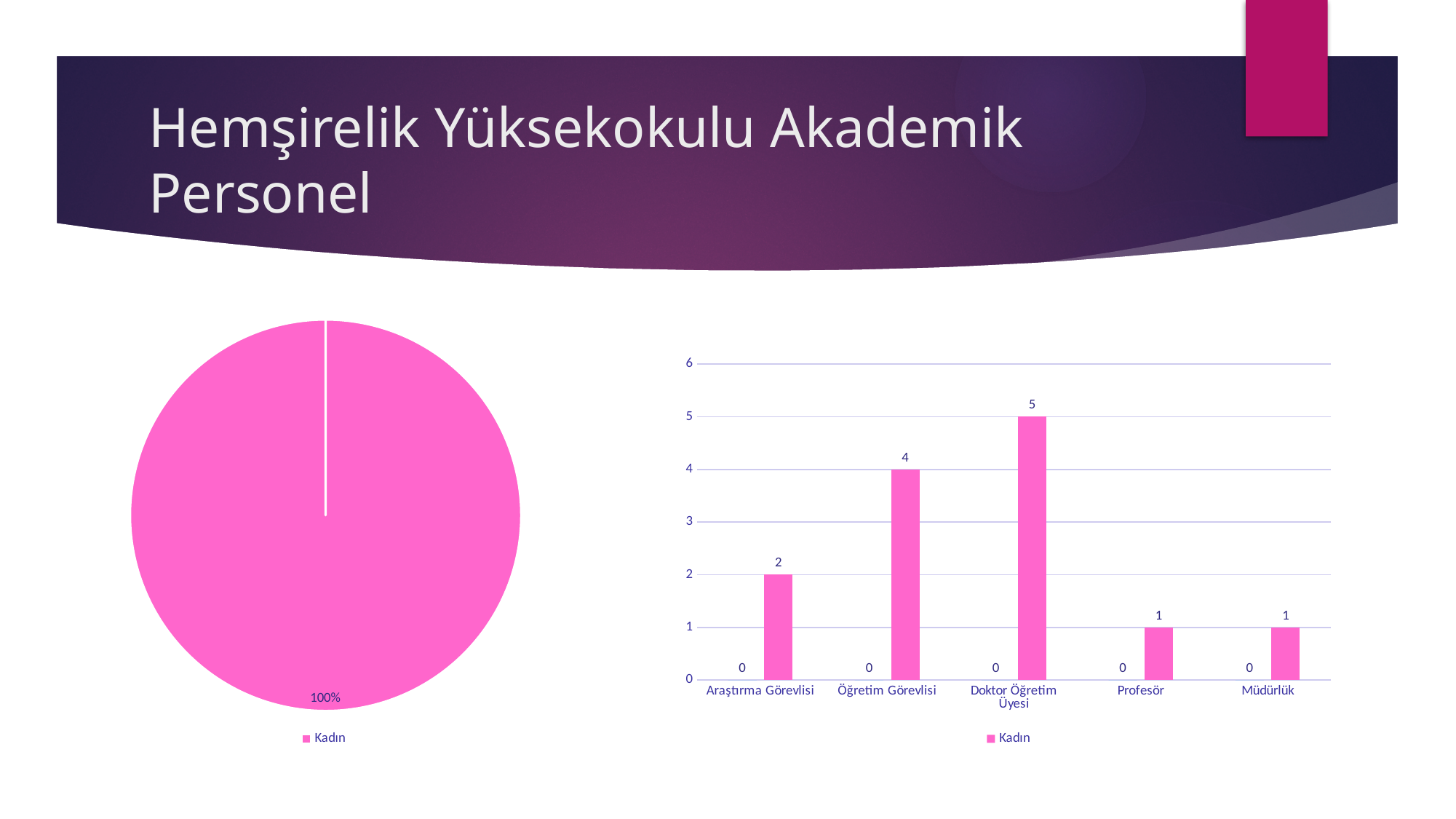
In the bar chart on the right, what is the value for Öğretim Görevlisi? 4 In the bar chart on the right, how many categories are shown on the x axis? 5 What kind of chart is the chart on the left of the slide? Pie chart What is the legend entry shown below the pie chart on the left? Kadın In the bar chart on the right, what is the value for Doktor Öğretim Üyesi? 5 In the bar chart on the right, what is the difference between the values for Doktor Öğretim Üyesi and Araştırma Görevlisi? 3 In the bar chart on the right, what is the value for Profesör? 1 In the bar chart on the right, what is the value for Araştırma Görevlisi? 2 What kind of chart is the chart on the right of the slide? Bar chart In the pie chart on the left, what share is shown for Kadın? 100% In the bar chart on the right, which is larger, the value for Öğretim Görevlisi or the value for Müdürlük? Öğretim Görevlisi In the bar chart on the right, which category has the highest value? Doktor Öğretim Üyesi